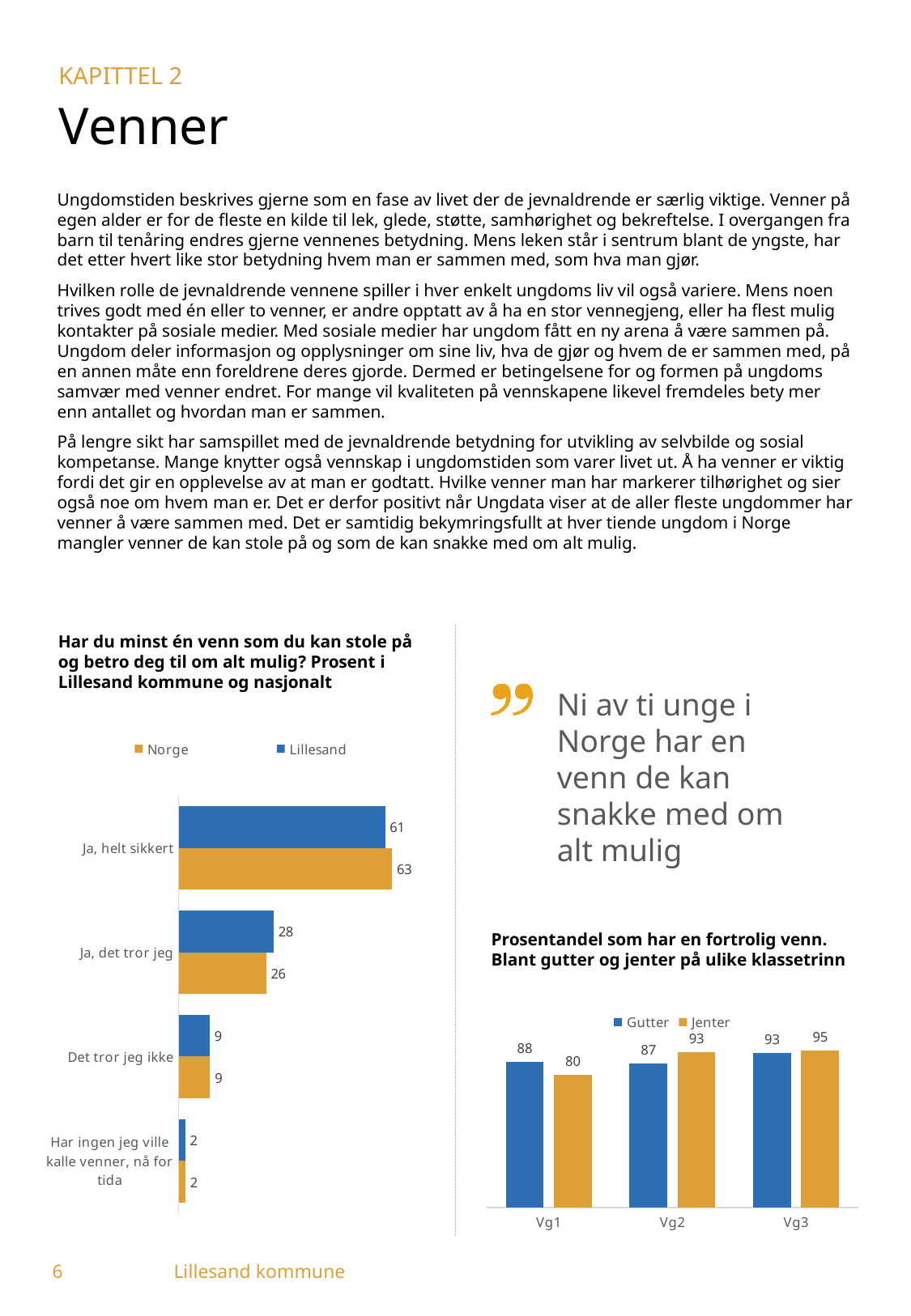
In the chart 'Har du minst én venn som du kan stole på...', what is the Lillesand value for 'Ja, helt sikkert'? 61 In the chart 'Prosentandel som har en fortrolig venn', which colour represents Gutter? Blue In the chart 'Har du minst én venn som du kan stole på...', what is the Norge value for 'Ja, det tror jeg'? 26 In the chart 'Prosentandel som har en fortrolig venn', what is the difference between Jenter and Gutter at Vg2? 6 In the chart 'Prosentandel som har en fortrolig venn', what is the Jenter value for Vg1? 80 In the chart 'Har du minst én venn som du kan stole på...', how many categories are shown? 4 In the chart 'Prosentandel som har en fortrolig venn', what is the Gutter value for Vg2? 87 In the chart 'Prosentandel som har en fortrolig venn', which group has the higher value at Vg3, Gutter or Jenter? Jenter In the chart 'Har du minst én venn som du kan stole på...', how many series does the legend list? 2 What kind of chart is 'Har du minst én venn som du kan stole på...'? Bar chart In the chart 'Har du minst én venn som du kan stole på...', which category has the lowest values? Har ingen jeg ville kalle venner, nå for tida In the chart 'Har du minst én venn som du kan stole på...', what is the difference between the Norge and Lillesand values for 'Ja, helt sikkert'? 2